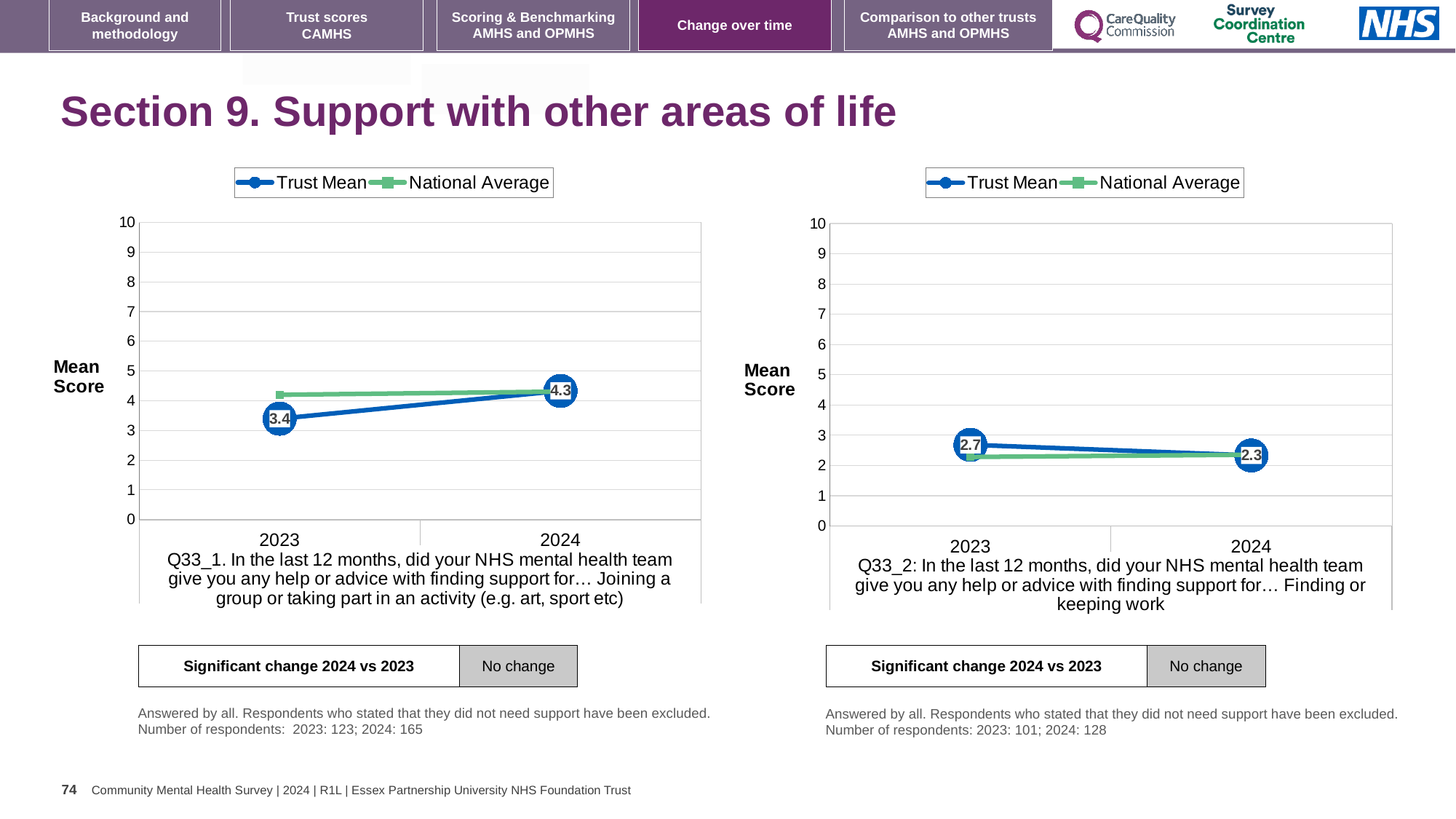
In the left chart (Q33_1), is the National Average value for 2023 greater or less than 5? less What kind of chart is the left chart (Q33_1)? line chart In the left chart (Q33_1), does the Trust Mean rise or fall from 2023 to 2024? rise In the left chart (Q33_1), which is larger in 2023: the Trust Mean or the National Average? National Average In the left chart (Q33_1), what is the Trust Mean score for 2024? 4.3 In the right chart (Q33_2), what is the difference between the Trust Mean in 2023 and 2024? 0.4 In the right chart (Q33_2), what is the Trust Mean score for 2023? 2.7 In the right chart (Q33_2), does the Trust Mean rise or fall from 2023 to 2024? fall How many series does the legend of the right chart (Q33_2) list? 2 In the left chart (Q33_1), by how much did the Trust Mean change from 2023 to 2024? 0.9 In the right chart (Q33_2), what is the Trust Mean score for 2024? 2.3 In the left chart (Q33_1), what is the Trust Mean score for 2023? 3.4